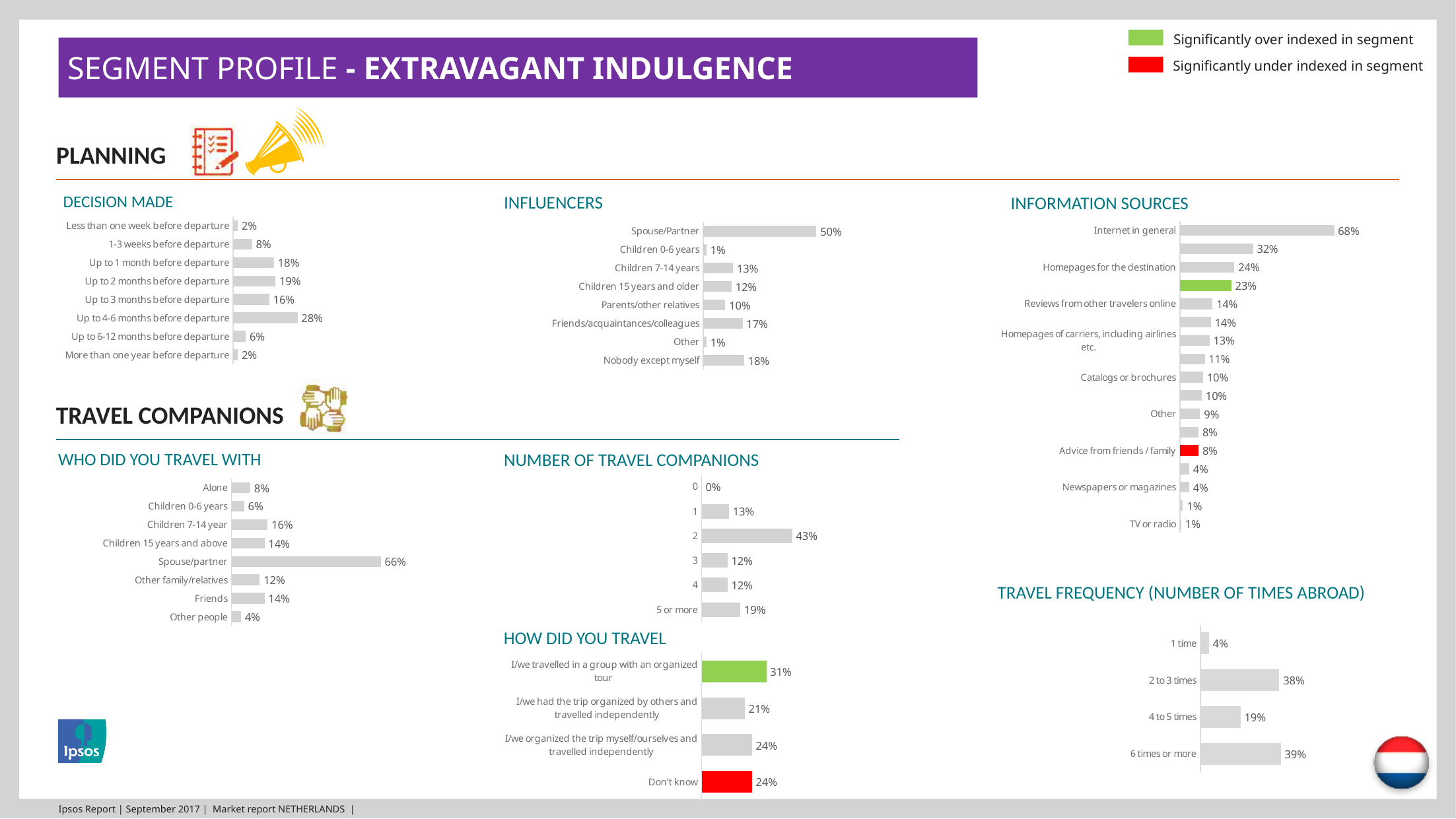
In the HOW DID YOU TRAVEL chart, what is the value for 'I/we travelled in a group with an organized tour'? 31% In the INFLUENCERS chart, what is the difference between 'Nobody except myself' and 'Children 7-14 years'? 5% In the NUMBER OF TRAVEL COMPANIONS chart, what is the value for '2'? 43% In the WHO DID YOU TRAVEL WITH chart, which category has the highest value? Spouse/partner In the WHO DID YOU TRAVEL WITH chart, how many categories are shown? 8 In the NUMBER OF TRAVEL COMPANIONS chart, which is larger: '1' or '5 or more'? 5 or more In the DECISION MADE chart, what is the value for 'Up to 4-6 months before departure'? 28% In the TRAVEL FREQUENCY (NUMBER OF TIMES ABROAD) chart, which category has the lowest value? 1 time In the DECISION MADE chart, which category has the highest value? Up to 4-6 months before departure In the INFORMATION SOURCES chart, which category is shown with a red bar? Advice from friends / family In the INFORMATION SOURCES chart, what is the value for 'Internet in general'? 68% In the INFLUENCERS chart, what is the value for 'Spouse/Partner'? 50%